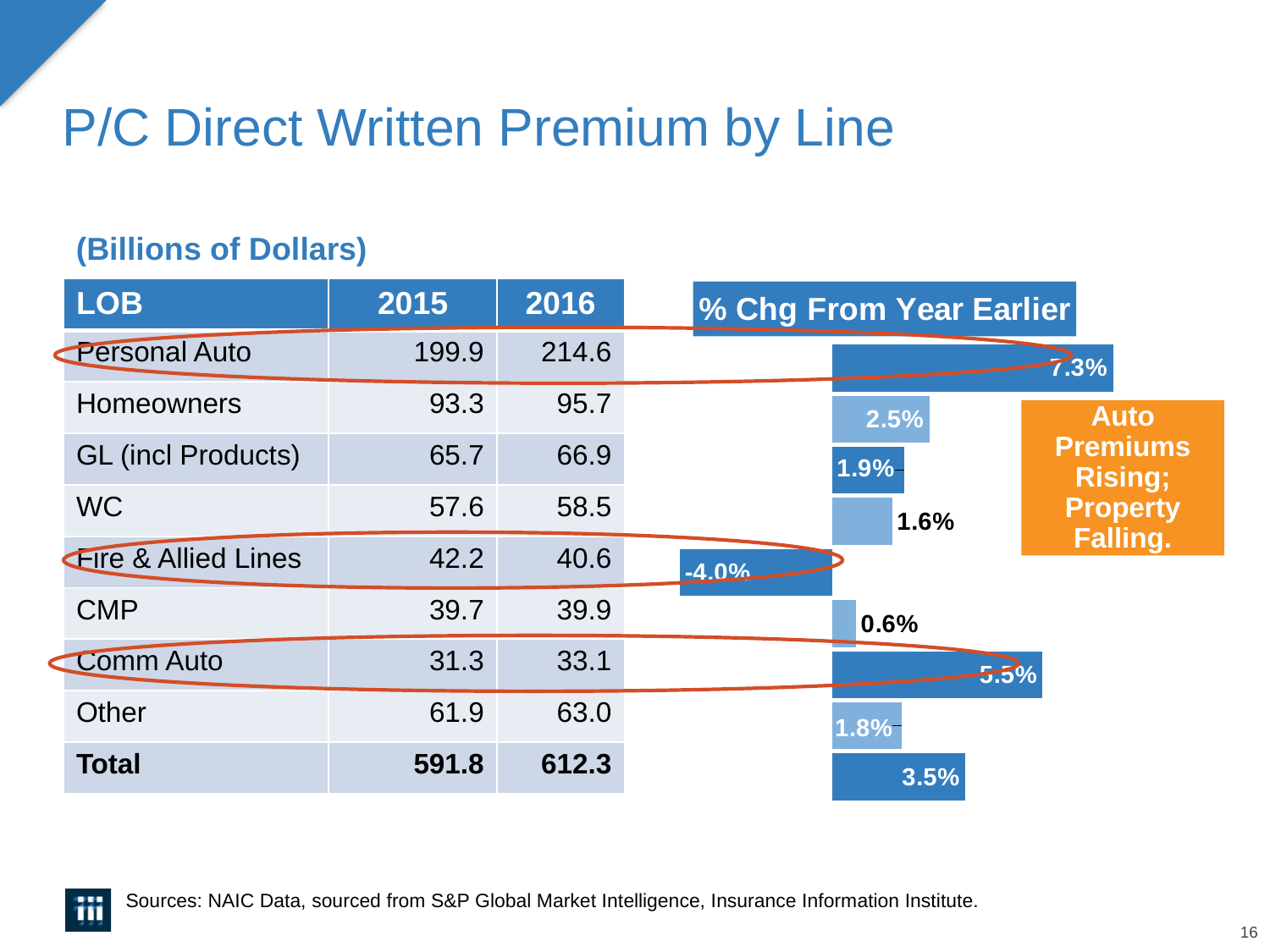
In the '% Chg From Year Earlier' chart, which has the larger percentage change, Homeowners or WC? Homeowners In the '% Chg From Year Earlier' chart, what is the difference between the percentage change for Personal Auto and for Comm Auto? 1.8% In the '% Chg From Year Earlier' chart, how many bars are plotted? 9 What is the title of the chart on the right side of the slide? % Chg From Year Earlier In the '% Chg From Year Earlier' chart, what is the percentage change shown for Fire & Allied Lines? -4.0% In the '% Chg From Year Earlier' chart, what is the percentage change shown for Comm Auto? 5.5% In the '% Chg From Year Earlier' chart, what is the percentage change shown for the Total row? 3.5% In the '% Chg From Year Earlier' chart, which line of business has the highest percentage change? Personal Auto In the '% Chg From Year Earlier' chart, what is the percentage change shown for Personal Auto? 7.3% In the '% Chg From Year Earlier' chart, which line of business has the lowest percentage change? Fire & Allied Lines In the '% Chg From Year Earlier' chart, how many bars show a negative percentage change? 1 What kind of chart is the '% Chg From Year Earlier' chart? Bar chart